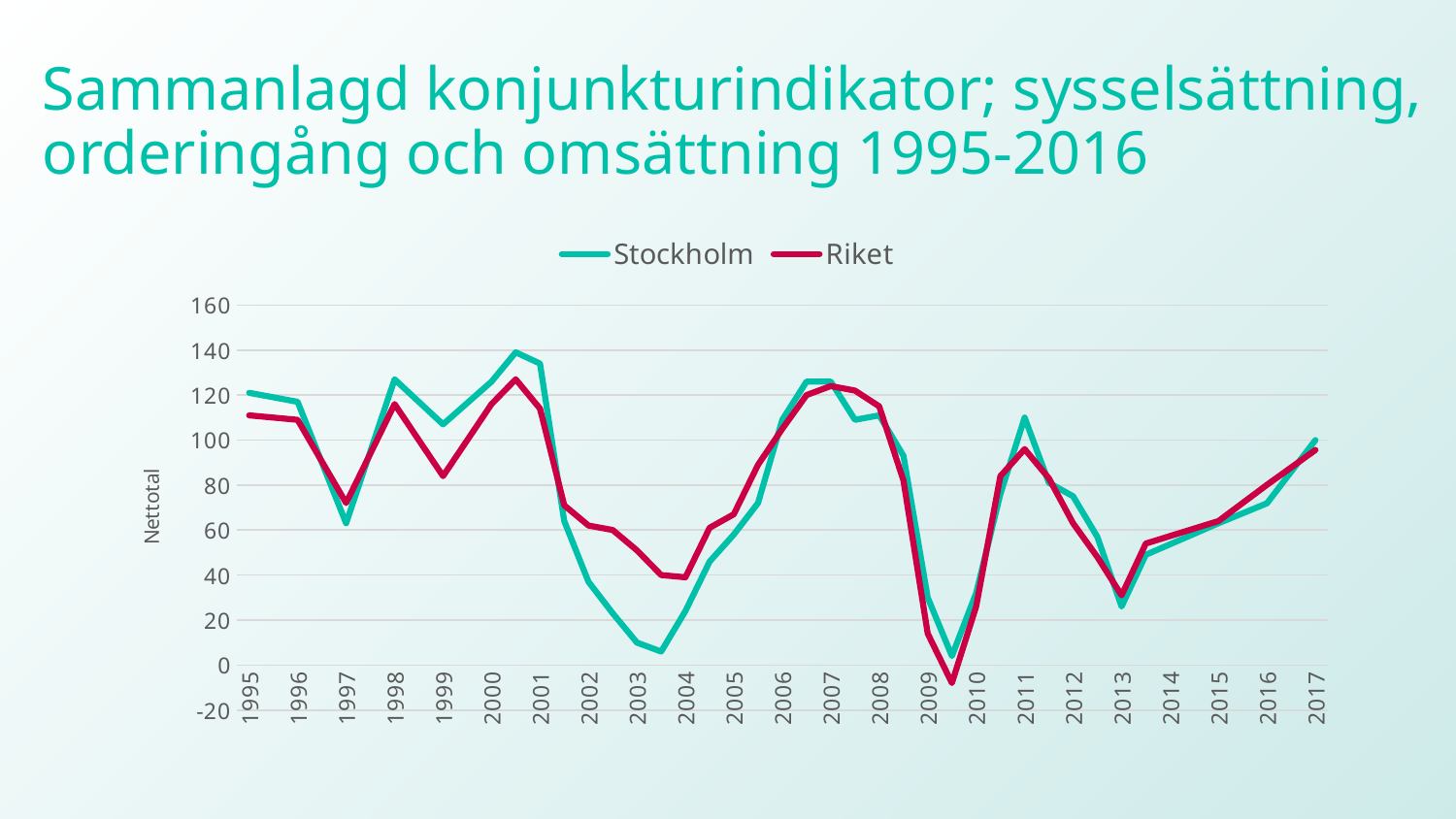
How many year labels are shown along the x axis? 23 Do the values for both series rise or fall between 2013 and 2017? rise Is the Riket value for 1999 greater or less than 100? less Is the Riket value for 2009 greater or less than 20? less What are the two series named in the legend? Stockholm and Riket In 2003, which series has the higher value, Stockholm or Riket? Riket What is the label on the vertical axis? Nettotal Is the Stockholm value for 2000 greater or less than 120? greater What kind of chart is shown on the slide? line chart How many series does the legend list? 2 In 1999, which series has the higher value, Stockholm or Riket? Stockholm